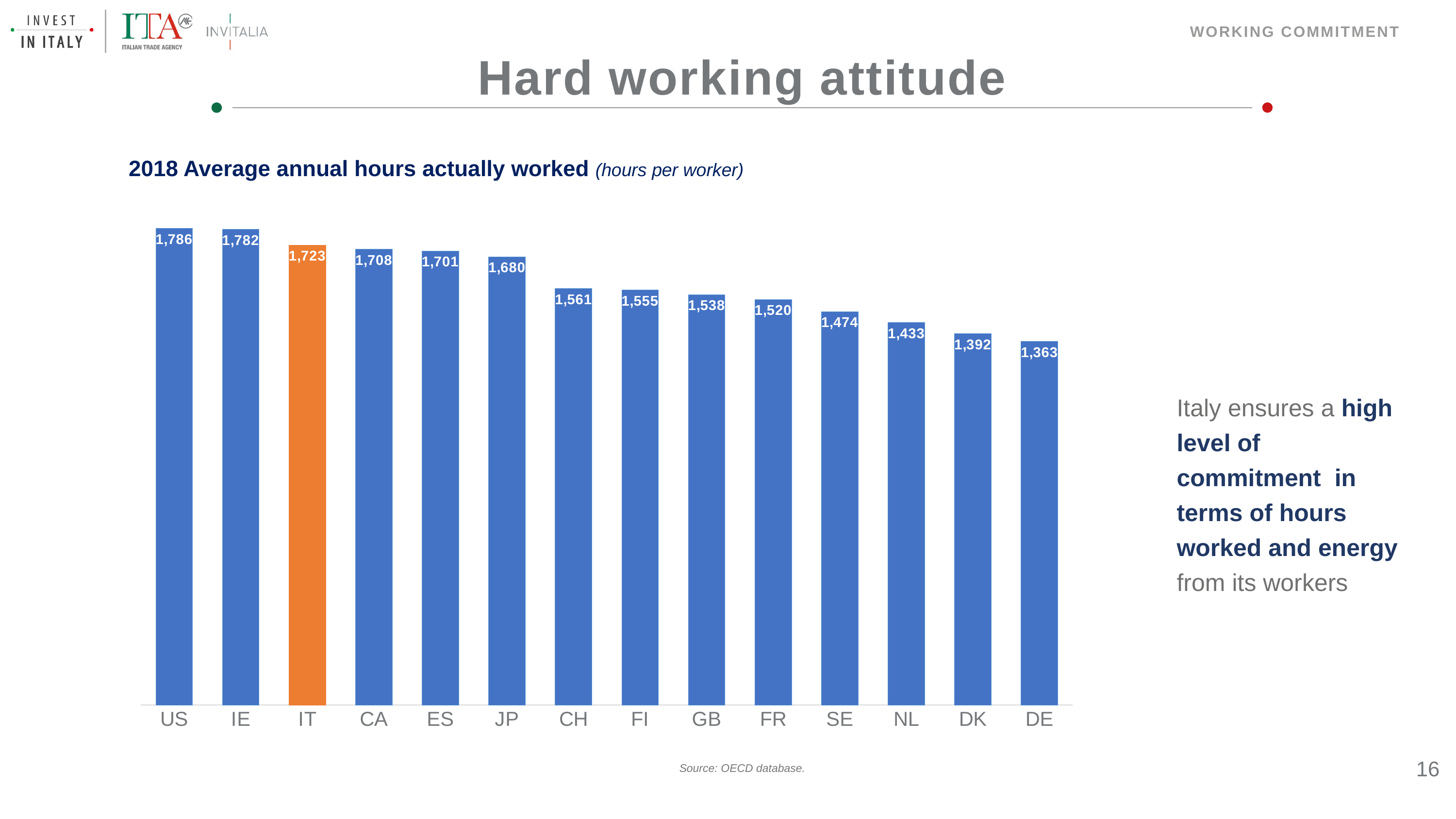
Which is larger, the value for CH or the value for FR? CH Which country has the highest average annual hours worked? US Which country has the lowest average annual hours worked? DE Which country's bar is coloured orange? IT What is the value for IT? 1,723 What kind of chart is shown on the slide? Bar chart What is the value for DE? 1,363 How many countries are shown in the chart? 14 Do the values rise or fall from left to right along the x axis? Fall What is the value for JP? 1,680 What is the difference between the values for US and IT? 63 What is the difference between the values for IT and DE? 360